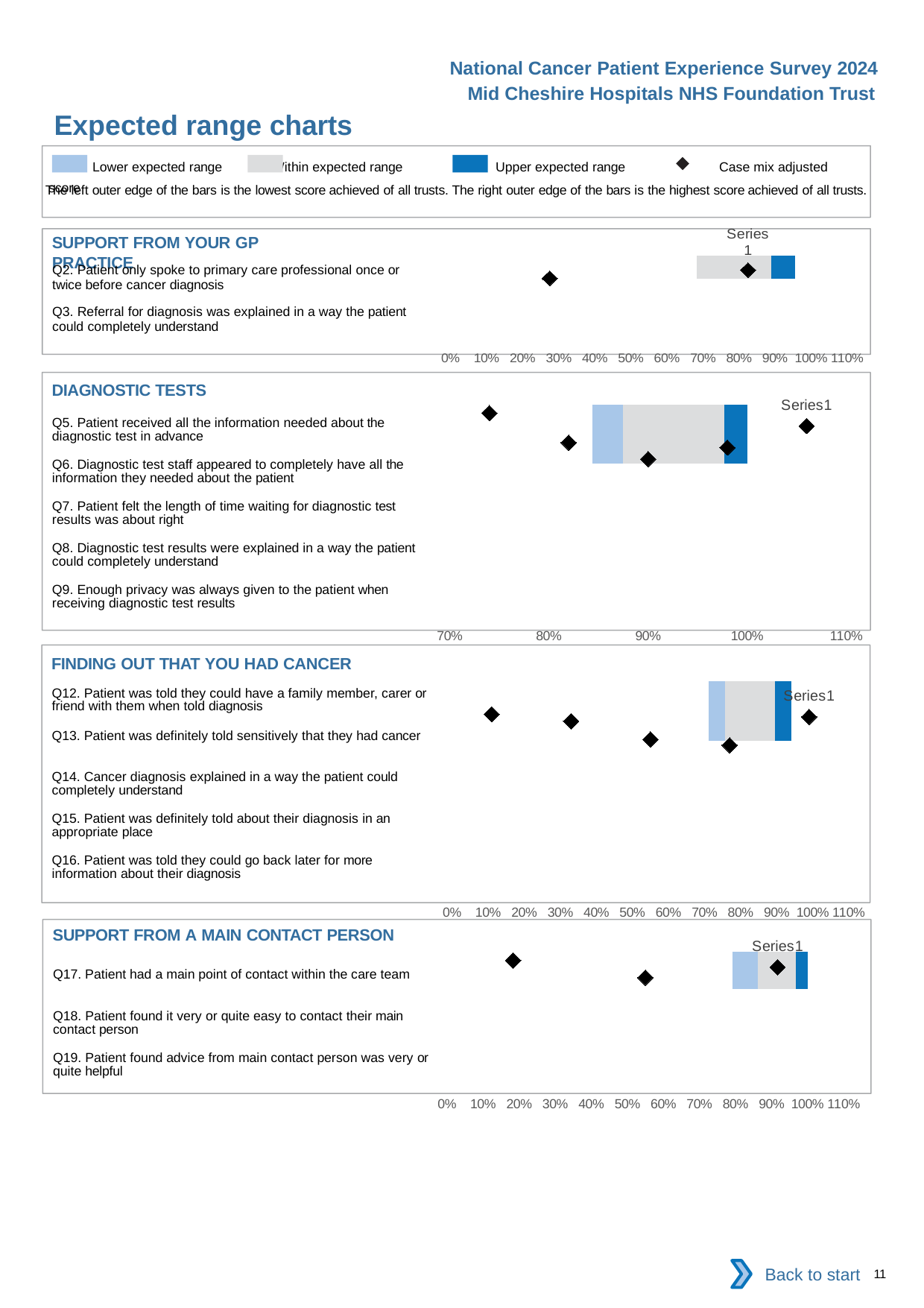
In the 'Support from your GP practice' chart, is the leftmost case mix adjusted score marker greater or less than 50%? less What kind of chart is used in the 'Diagnostic tests' section of the slide? bar chart How many questions are listed in the 'Support from a main contact person' chart? 3 How many entries does the legend at the top of the slide list? 4 How many questions are listed in the 'Diagnostic tests' chart? 5 In the 'Diagnostic tests' chart, what is the lowest value shown on the x axis? 70% In the 'Diagnostic tests' chart, is the leftmost case mix adjusted score marker greater or less than 80%? less In the 'Support from a main contact person' chart, what is the highest value shown on the x axis? 110% In the 'Finding out that you had cancer' chart, is the leftmost case mix adjusted score marker greater or less than 30%? less How many questions are listed in the 'Support from your GP practice' chart? 2